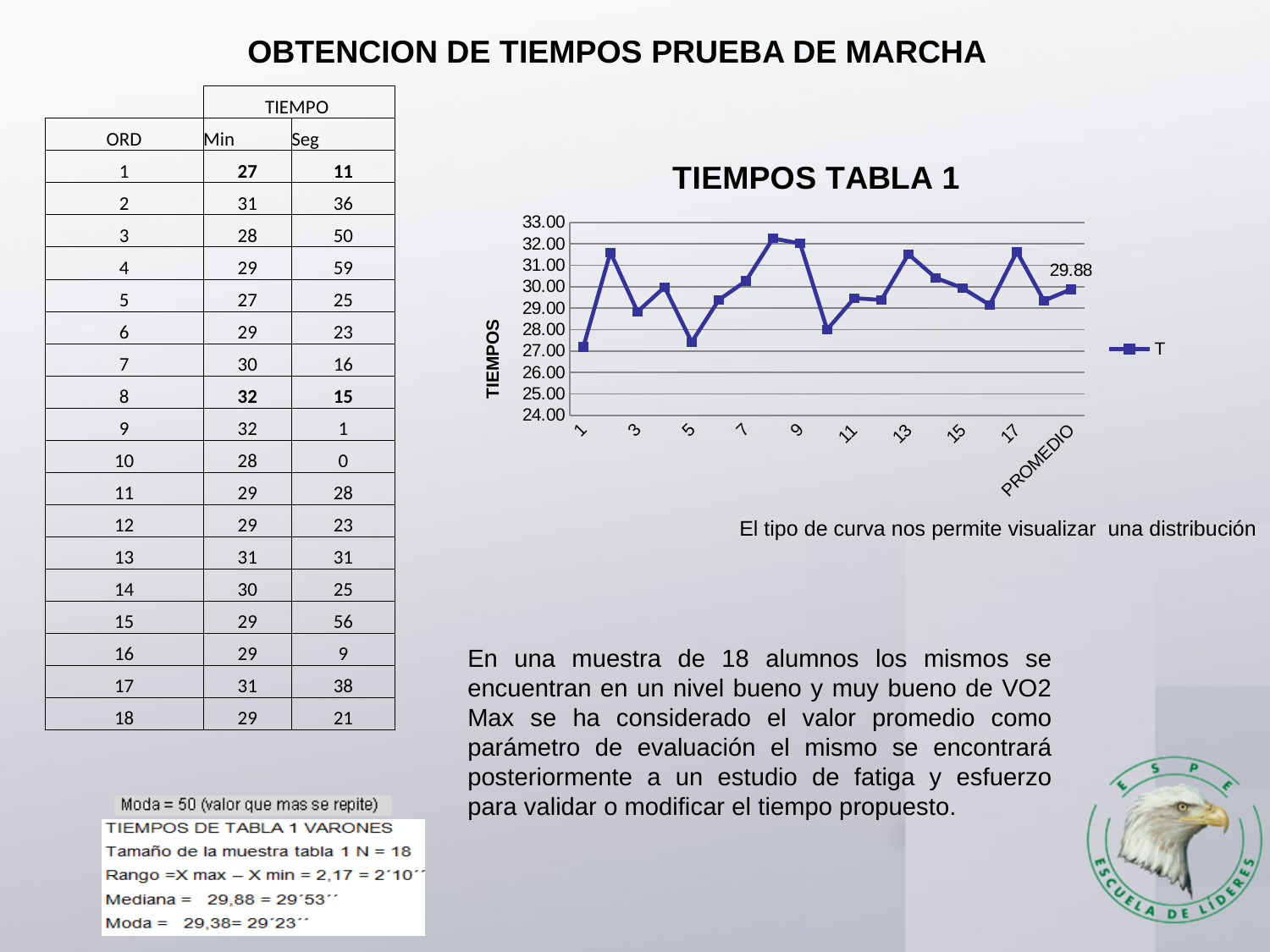
What is the title of the chart? TIEMPOS TABLA 1 How many series does the chart legend list? 1 Which has the larger value in the chart, category 10 or category 13? 13 What value is labelled for PROMEDIO in the chart? 29.88 Is the value for category 1 in the chart greater or less than 28.00? less Is the value for category 10 in the chart greater or less than 29.00? less How many points are plotted along the x axis of the chart, including PROMEDIO? 19 Which has the larger value in the chart, category 2 or category 3? 2 Is the value for category 5 in the chart greater or less than 28.00? less What is the name of the series shown in the chart legend? T What kind of chart is shown on the slide? line chart